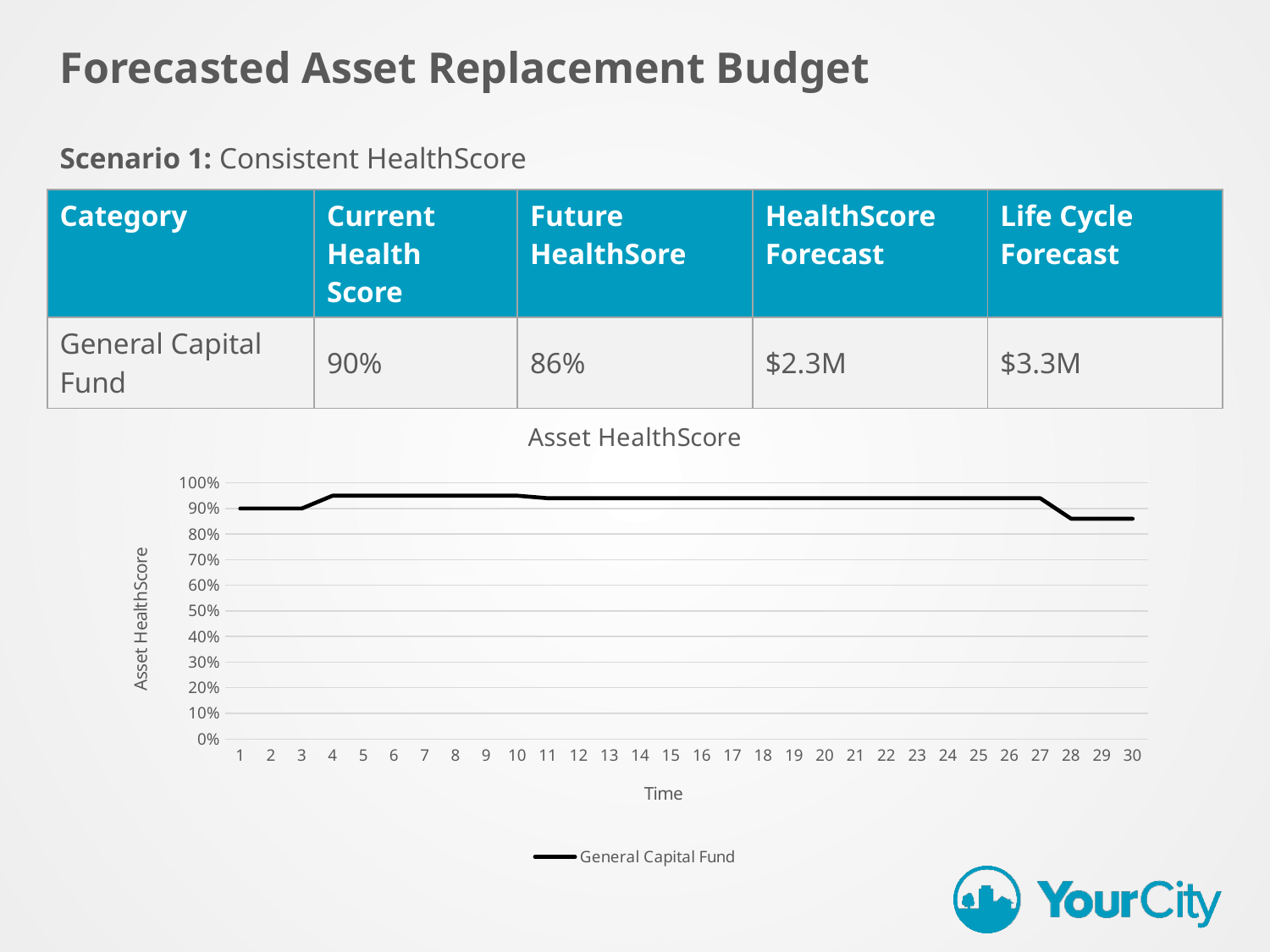
Is the value for General Capital Fund at time 5 greater or less than 90%? greater What is the title of the chart on the slide? Asset HealthScore How many series does the legend of the Asset HealthScore chart list? 1 How many time points are plotted along the x axis of the Asset HealthScore chart? 30 Is the value for General Capital Fund at time 15 greater or less than 90%? greater Is the value for General Capital Fund at time 29 greater or less than 80%? greater Which is larger in the Asset HealthScore chart: the value at time 10 or the value at time 30? time 10 What is the value of General Capital Fund at time 1 in the Asset HealthScore chart? 90% Between time 27 and time 30, does the General Capital Fund line rise or fall? fall What kind of chart is shown on the slide? line chart What is the label of the x axis of the Asset HealthScore chart? Time